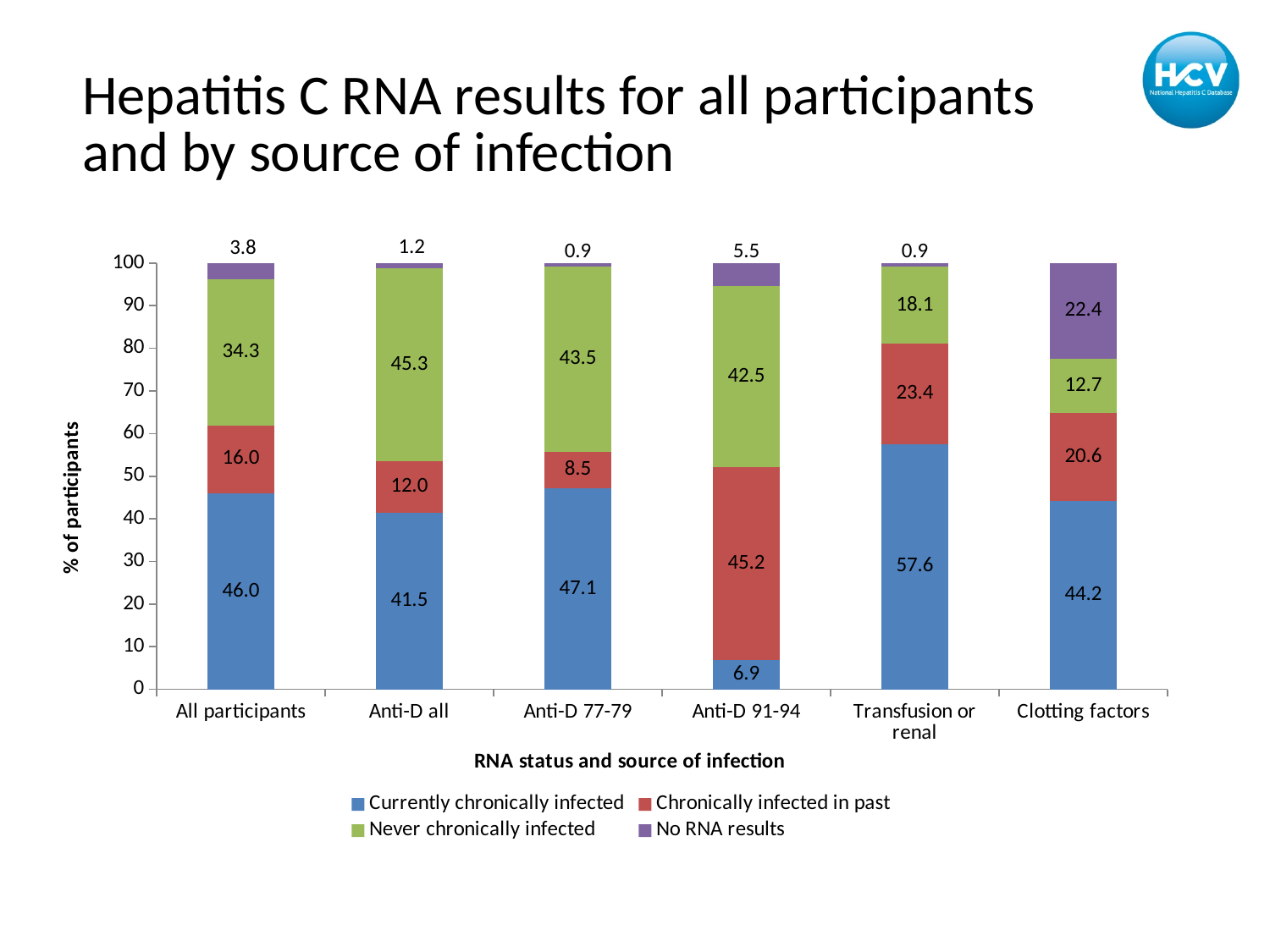
How many series does the legend list? 4 What is the difference between the 'Chronically infected in past' values for 'Anti-D 91-94' and 'Anti-D 77-79'? 36.7 Which is larger: the 'Never chronically infected' value for 'Anti-D 77-79' or for 'Anti-D 91-94'? Anti-D 77-79 What type of chart is shown on the slide? Stacked bar chart What is the value for 'No RNA results' in the 'Anti-D 91-94' bar? 5.5 Which category has the lowest value for 'Currently chronically infected'? Anti-D 91-94 What is the value for 'Never chronically infected' in the 'Anti-D all' bar? 45.3 Which category has the highest value for 'Currently chronically infected'? Transfusion or renal How many categories are shown along the x axis? 6 What is the value for 'Currently chronically infected' in the 'All participants' bar? 46.0 What is the label of the y axis? % of participants What is the value for 'No RNA results' in the 'Clotting factors' bar? 22.4